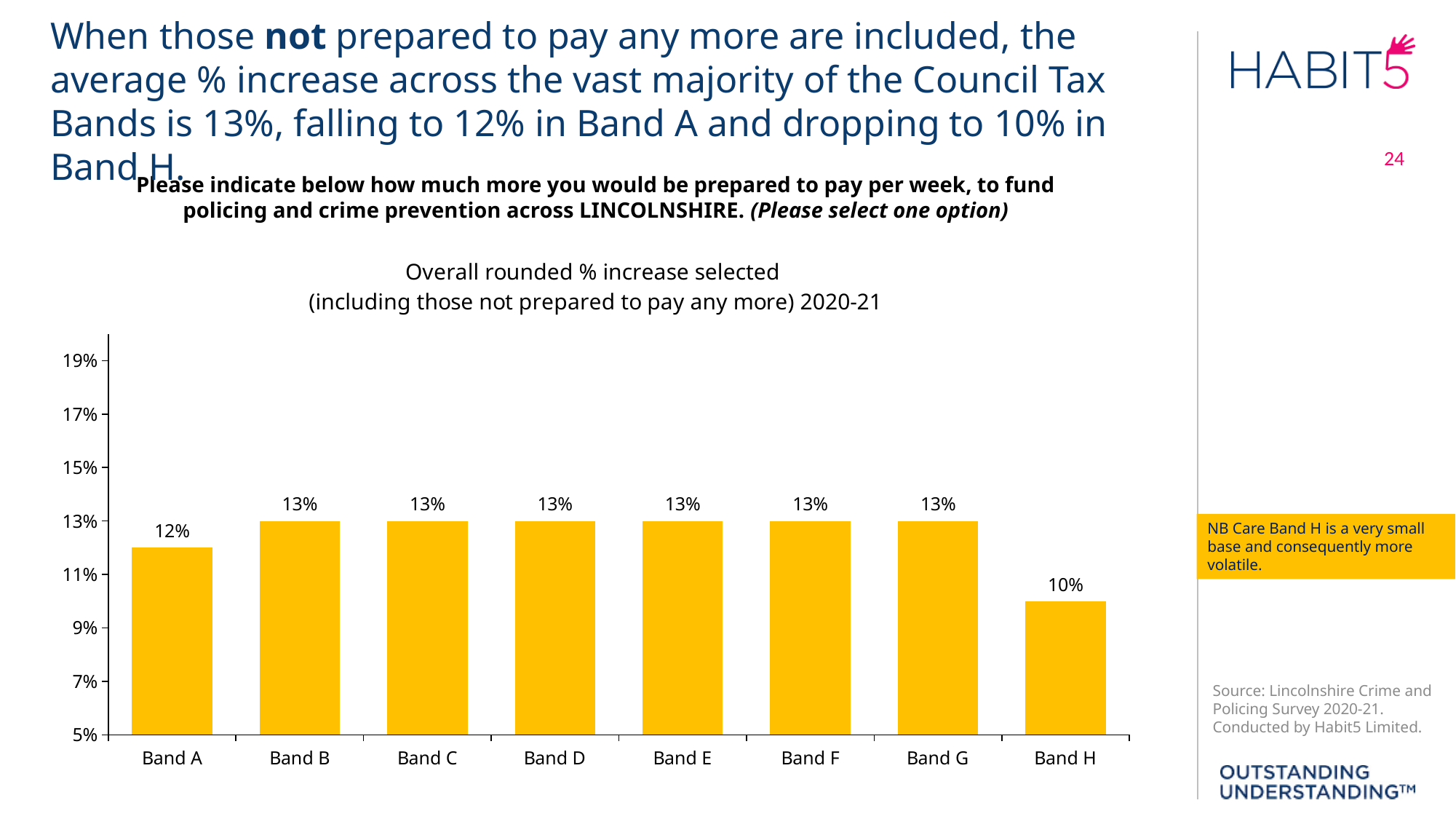
What colour are the bars in the chart? yellow Is the value for Band H greater or less than 11%? less What kind of chart is shown? bar chart What is the value for Band H? 10% Which band has the lowest value? Band H How many bands have a value of 13%? 6 What is the value for Band A? 12% What is the difference between the values for Band A and Band H? 2% What is the value for Band D? 13% How many bands are shown on the x axis? 8 Which is larger, the value for Band A or the value for Band G? Band G What is the difference between the values for Band B and Band H? 3%